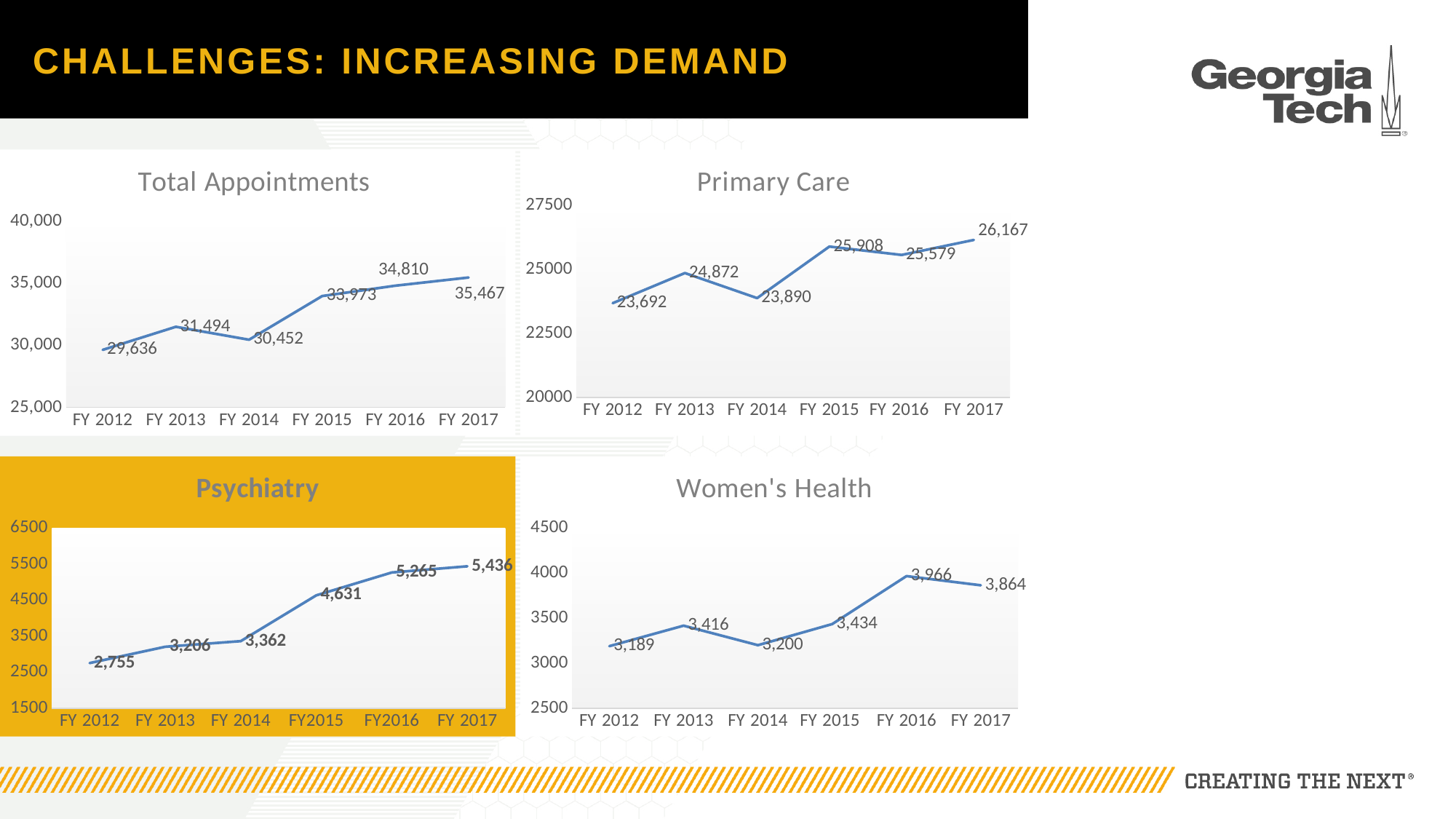
In the Primary Care chart, is the value for FY 2017 greater or less than 25000? greater What kind of chart is the Women's Health chart? line chart In the Total Appointments chart, what is the difference between FY 2015 and FY 2014? 3,521 In the Psychiatry chart, what is the difference between the FY 2017 value and the FY 2012 value? 2,681 In the Total Appointments chart, do the values generally rise or fall from FY 2012 to FY 2017? rise In the Primary Care chart, what is the value for FY 2014? 23,890 How many fiscal years are plotted in the Psychiatry chart? 6 In the Psychiatry chart, what is the value for FY 2012? 2,755 In the Women's Health chart, which fiscal year has the highest value? FY 2016 In the Women's Health chart, which is larger, the value for FY 2013 or the value for FY 2014? FY 2013 In the Total Appointments chart, what is the value for FY 2017? 35,467 In the Primary Care chart, which fiscal year has the lowest value? FY 2012